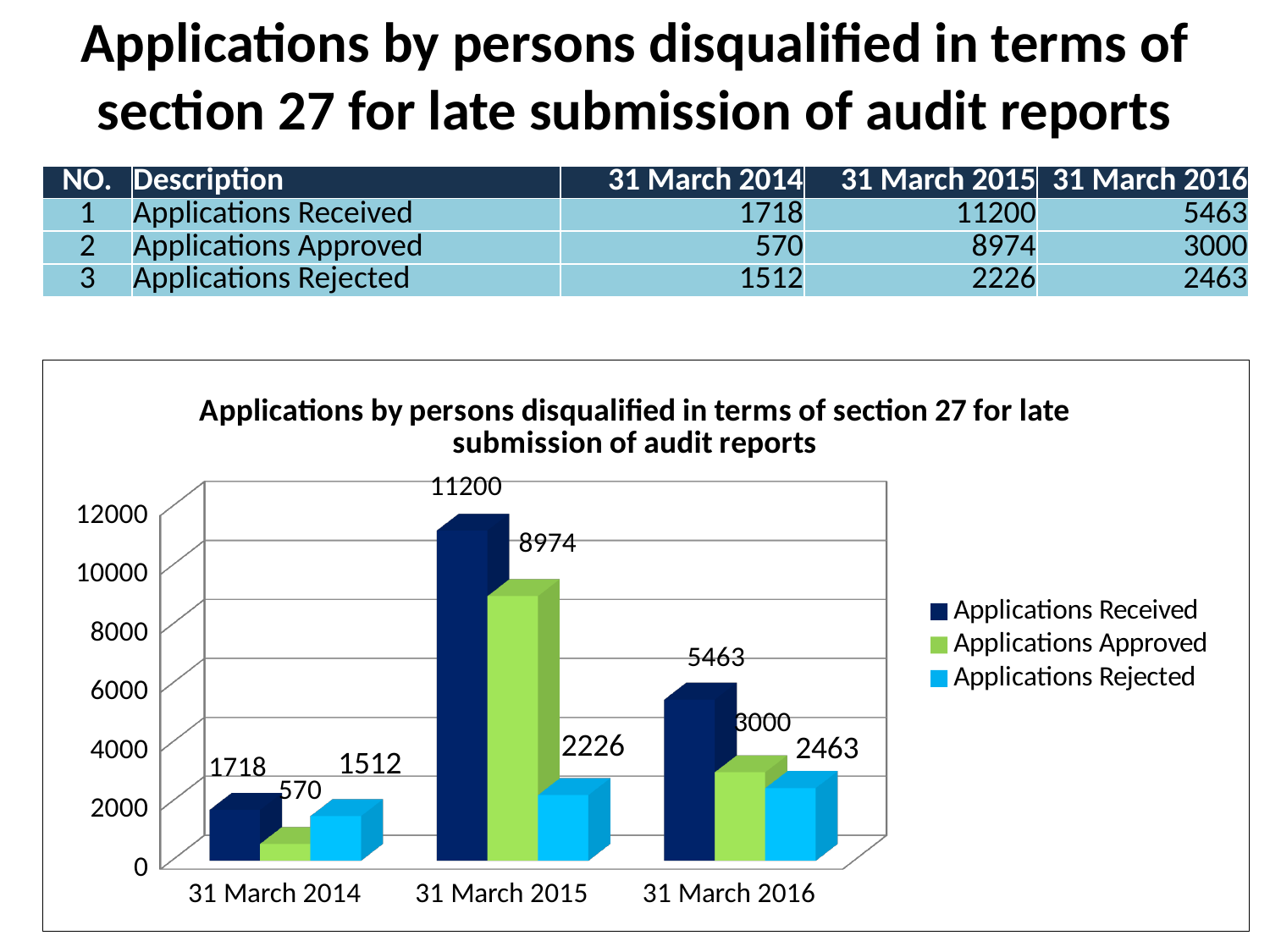
Which colour represents Applications Rejected in the chart? Light blue Which date has the highest value for Applications Received? 31 March 2015 What is the value for Applications Received on 31 March 2015? 11200 Which is larger on 31 March 2014: Applications Approved or Applications Rejected? Applications Rejected What kind of chart is shown on the slide? Bar chart What is the value for Applications Rejected on 31 March 2016? 2463 How many dates are shown on the x axis of the chart? 3 How many series does the chart legend list? 3 Which date has the lowest value for Applications Approved? 31 March 2014 What is the value for Applications Approved on 31 March 2014? 570 What is the difference between Applications Received and Applications Approved on 31 March 2015? 2226 What is the difference between Applications Received on 31 March 2016 and on 31 March 2014? 3745